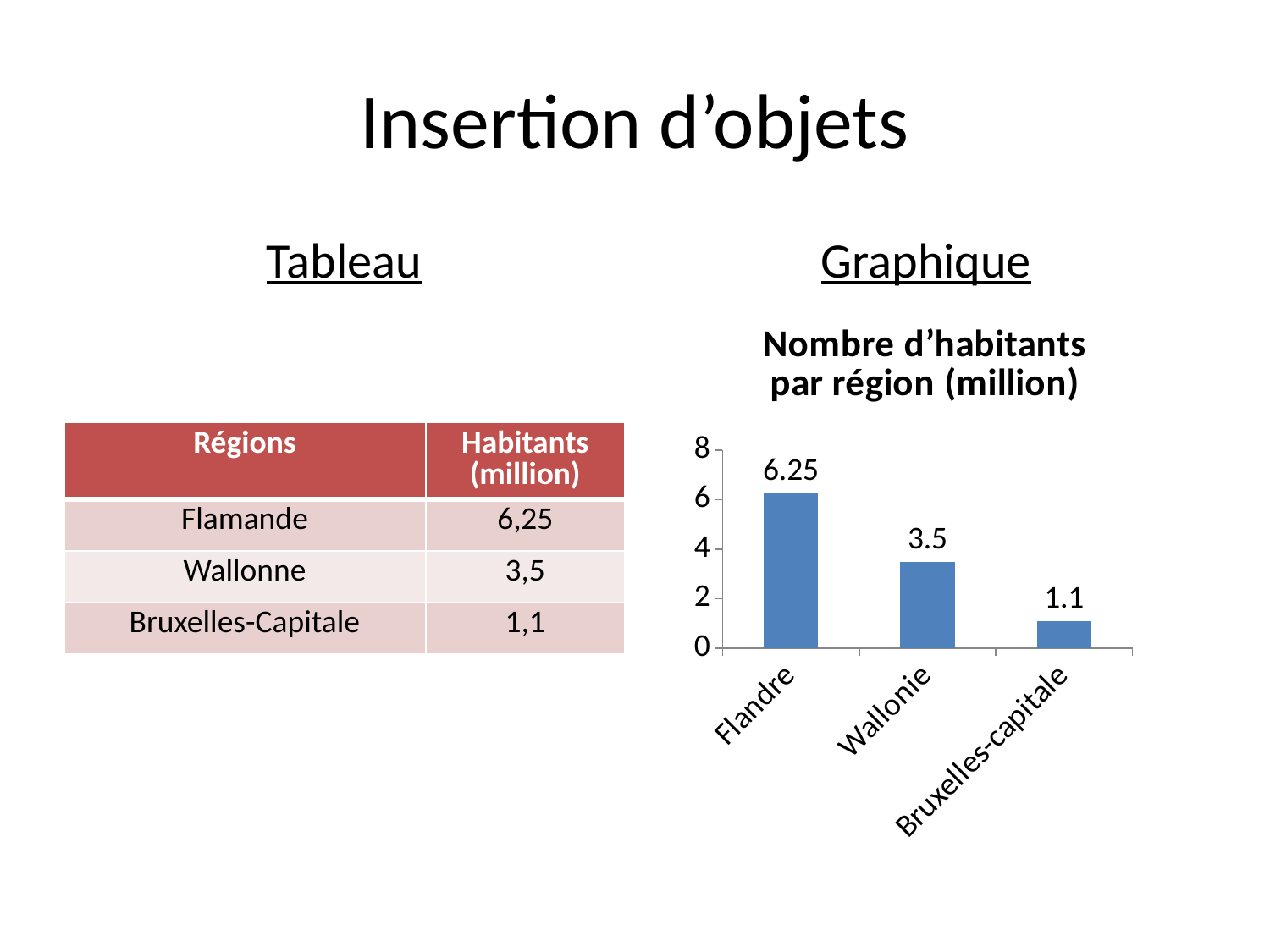
What is the title of the chart? Nombre d’habitants par région (million) What is the value for Bruxelles-capitale in the chart? 1.1 How many regions are shown in the chart? 3 Which region has the lowest value in the chart? Bruxelles-capitale Is the value for Flandre greater or less than 6? greater Which region has the highest value in the chart? Flandre What is the value for Flandre in the chart? 6.25 What kind of chart is shown on the slide? bar chart What is the value for Wallonie in the chart? 3.5 What is the difference between the values for Wallonie and Bruxelles-capitale? 2.4 Which is larger, the value for Wallonie or the value for Bruxelles-capitale? Wallonie What is the difference between the values for Flandre and Wallonie? 2.75